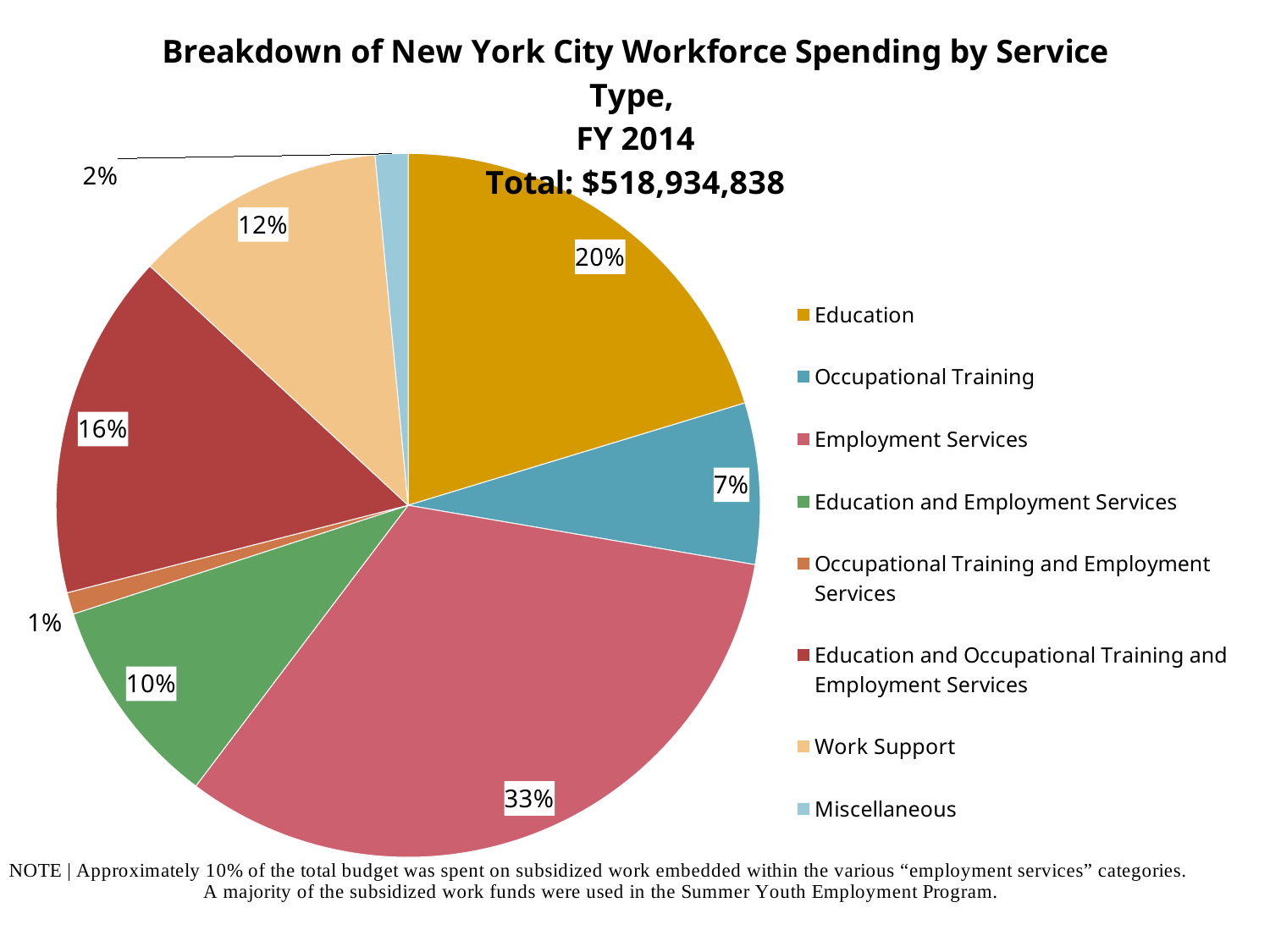
What total spending amount is shown in the chart title? $518,934,838 How many service types does the legend list? 8 Which service type has the smallest share of spending? Occupational Training and Employment Services Which has a larger share, Work Support or Education and Employment Services? Work Support What share of spending goes to Education? 20% Which service type has the largest share of spending? Employment Services What share of spending goes to Education and Occupational Training and Employment Services? 16% What share of spending goes to Work Support? 12% What is the difference in percentage points between the Employment Services share and the Education share? 13 percentage points What type of chart is shown on the slide? Pie chart